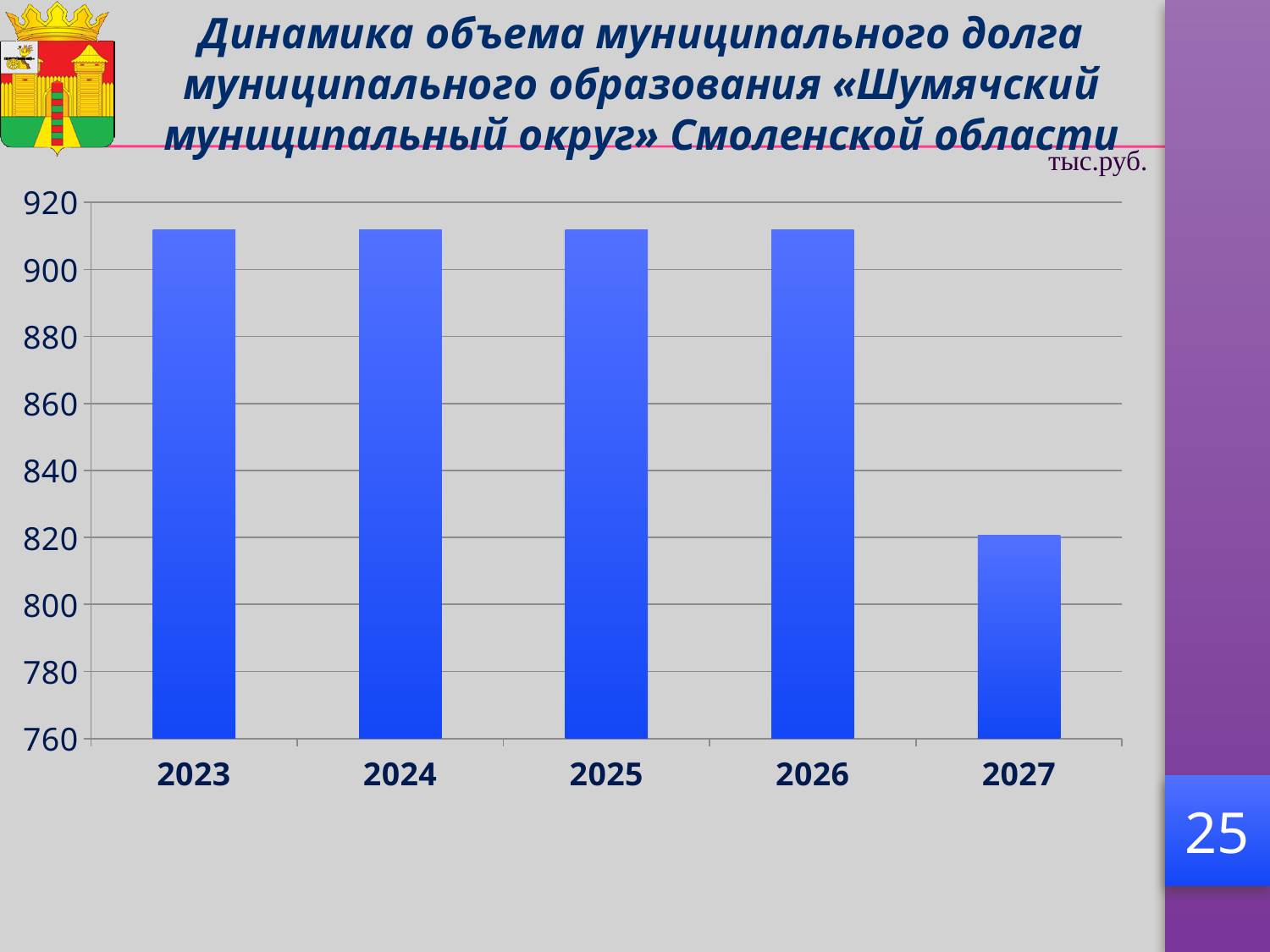
Which is larger, the value for 2026 or the value for 2027? 2026 What unit is indicated above the chart? тыс.руб. Is the value for 2027 greater or less than 840? less What kind of chart is shown on the slide? bar chart Is the value for 2026 greater or less than 920? less How many years are shown on the x axis of the chart? 5 Which year has the lowest value in the chart? 2027 What is the lowest value shown on the vertical axis of the chart? 760 Is the value for 2023 greater or less than 900? greater Do the values rise or fall from 2026 to 2027? fall